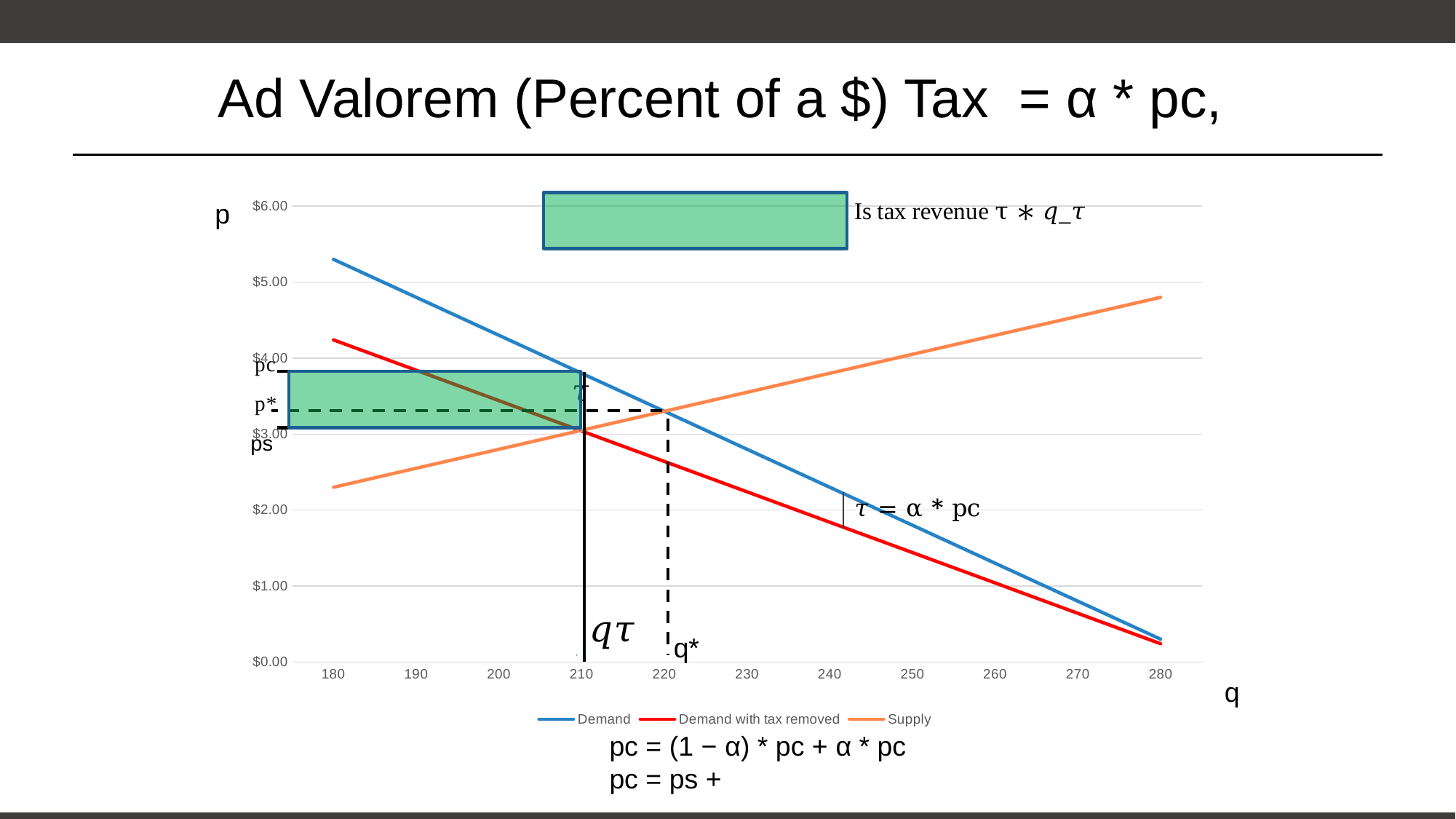
Is the value of the Supply line at q = 180 greater or less than $3.00? less How many series does the chart's legend list? 3 Is the value of the Demand line at q = 180 greater or less than $5.00? greater What are the three series named in the legend? Demand, Demand with tax removed, Supply Does the Demand line rise or fall as q increases along the x axis? falls What colour is the Supply line in the chart? orange What kind of chart is shown on the slide? line chart Does the Supply line rise or fall as q increases along the x axis? rises Is the value of the Demand with tax removed line at q = 280 greater or less than $1.00? less At q = 280, which is higher: the Supply line or the Demand line? Supply At q = 180, which is higher: the Demand line or the Supply line? Demand